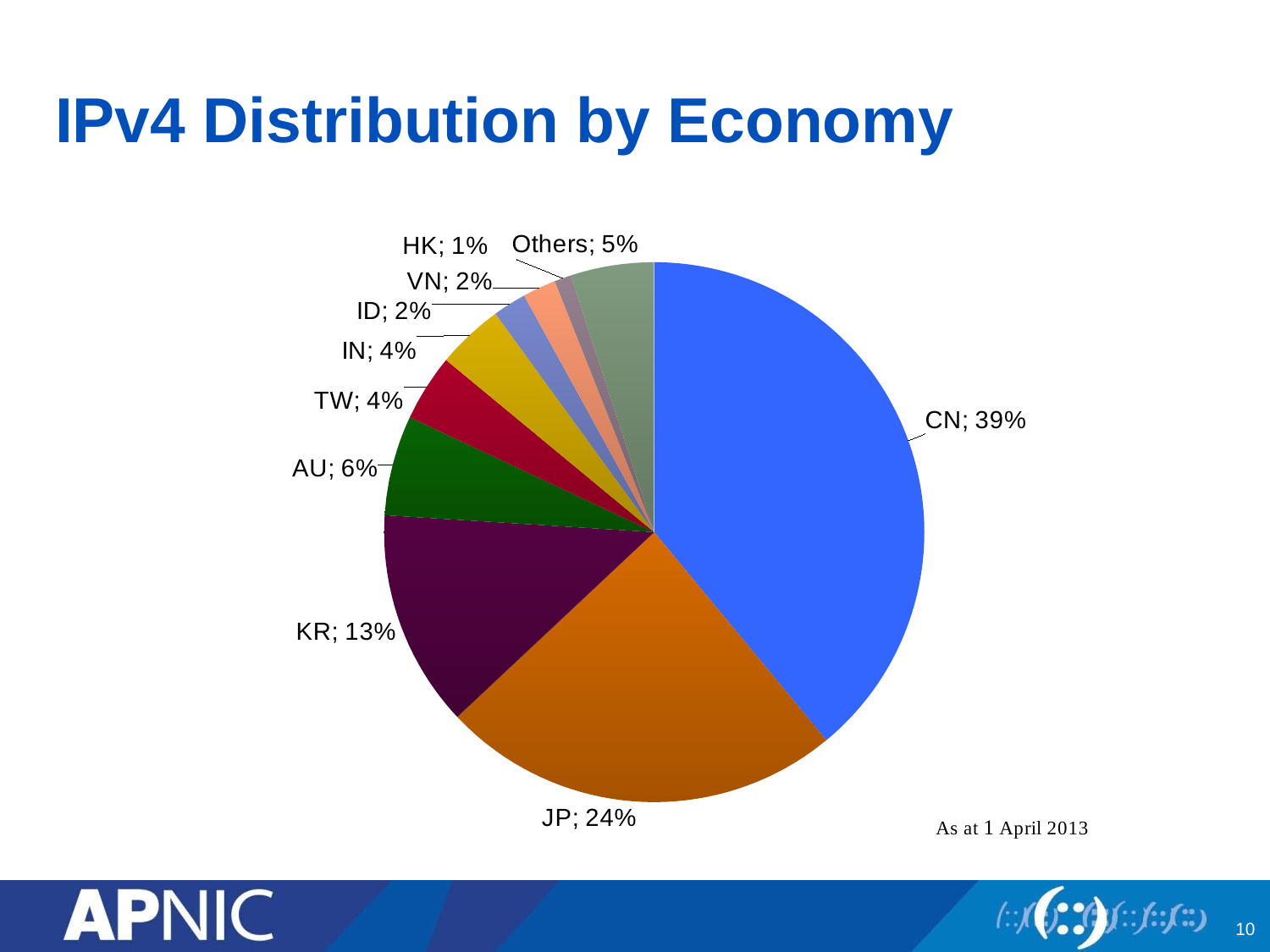
How many slices does the pie chart have? 10 What share of the pie does AU have? 6% What share of the pie does KR have? 13% What share of the pie does HK have? 1% Which economy has the largest slice of the pie? CN What kind of chart is shown on the slide? Pie chart Which is larger, the share for KR or the share for AU? KR What share of the pie does JP have? 24% What is the difference in percentage points between CN and JP? 15 What is the title of the chart on the slide? IPv4 Distribution by Economy Which economy has the smallest slice of the pie? HK What share of the pie does CN have? 39%